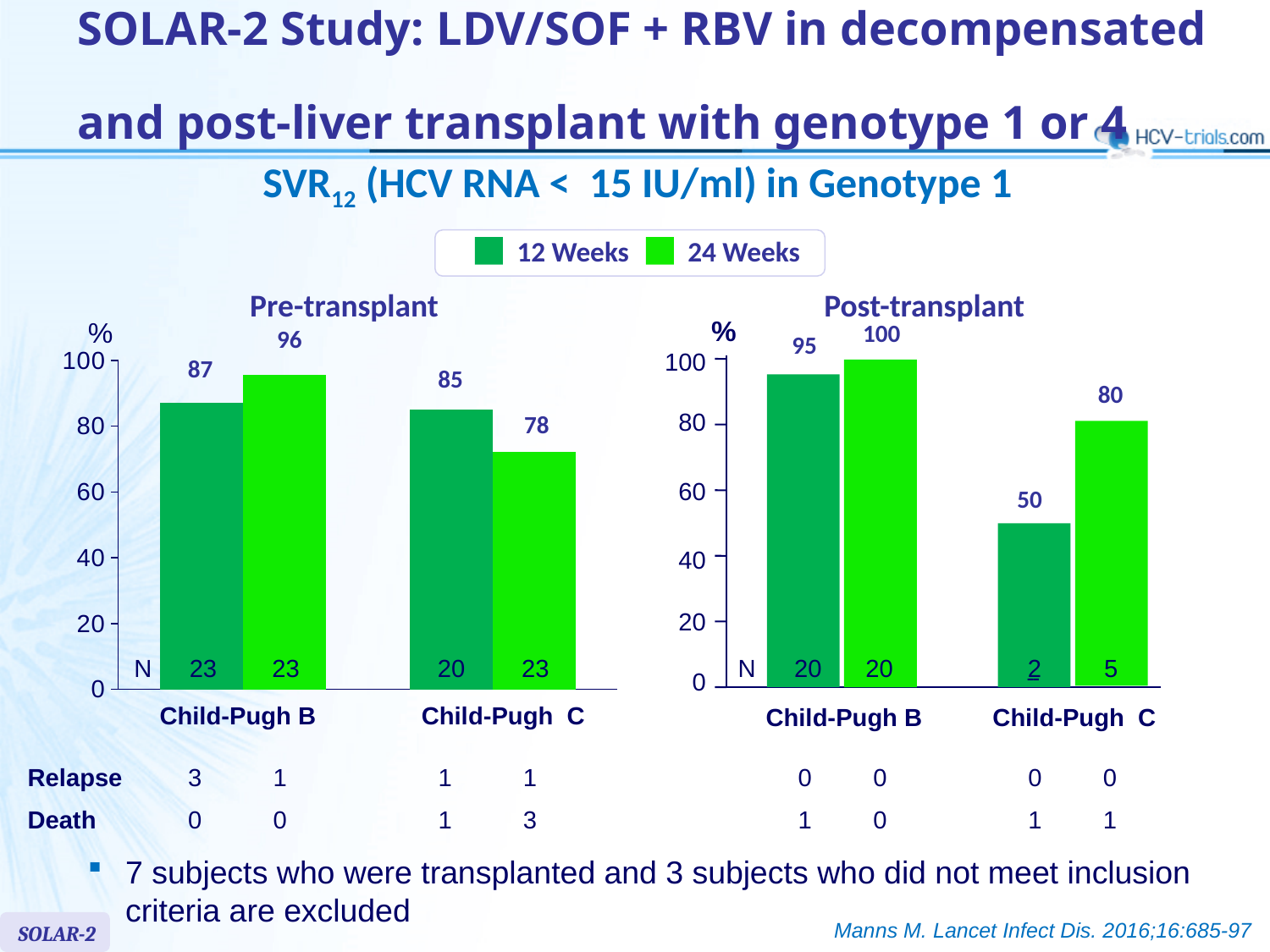
In the Post-transplant chart, which bar has the lowest value? Child-Pugh C, 12 Weeks In the Pre-transplant chart, what is the SVR12 value for Child-Pugh B at 12 Weeks? 87 In the Pre-transplant chart, which is larger for Child-Pugh C: the 12 Weeks value or the 24 Weeks value? 12 Weeks How many series does the legend list? 2 What are the two series named in the legend? 12 Weeks and 24 Weeks In the Pre-transplant chart, what is the SVR12 value for Child-Pugh C at 24 Weeks? 78 In the Pre-transplant chart, what is the difference between the 24 Weeks and 12 Weeks values for Child-Pugh B? 9 In the Post-transplant chart, what is the SVR12 value for Child-Pugh B at 24 Weeks? 100 In the Post-transplant chart, what is the SVR12 value for Child-Pugh C at 12 Weeks? 50 In the Post-transplant chart, what is the difference between the 24 Weeks and 12 Weeks values for Child-Pugh C? 30 In the Pre-transplant chart, which bar has the highest value? Child-Pugh B, 24 Weeks What type of chart is the Post-transplant chart? Bar chart